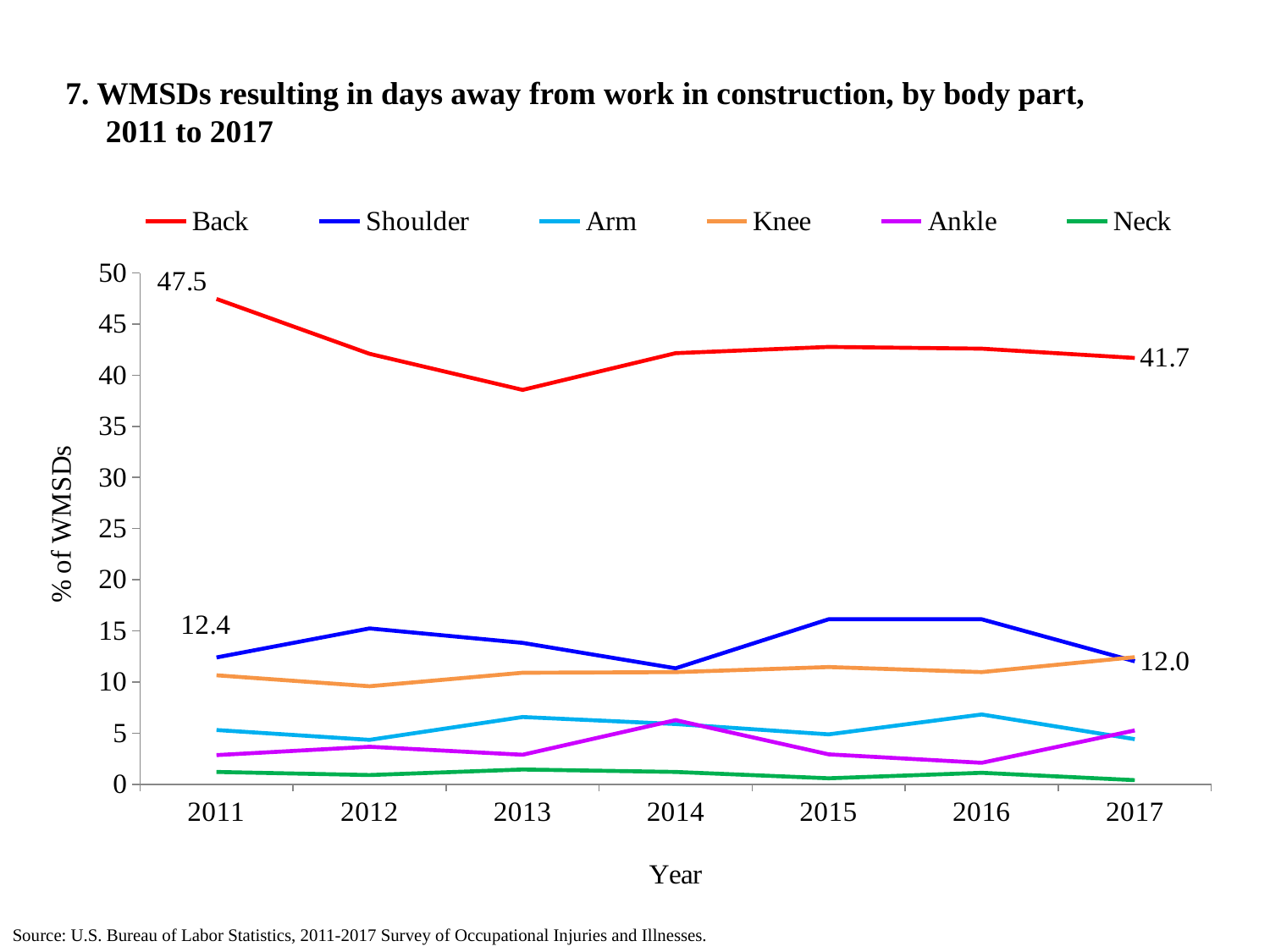
Is the value for Shoulder in 2015 greater or less than 15? greater Is the value for Back in 2013 greater or less than 40? less Does the Back line rise or fall from 2011 to 2013? fall Which body part has the lowest share of WMSDs across all years? Neck What is the value for Back in 2011? 47.5 How many series does the legend list? 6 What is the value for Back in 2017? 41.7 Which body part has the highest share of WMSDs across all years? Back By how much did the Back value decrease from 2011 to 2017? 5.8 What kind of chart is shown on the slide? line chart How many years are plotted along the x axis? 7 What is the value for Shoulder in 2011? 12.4